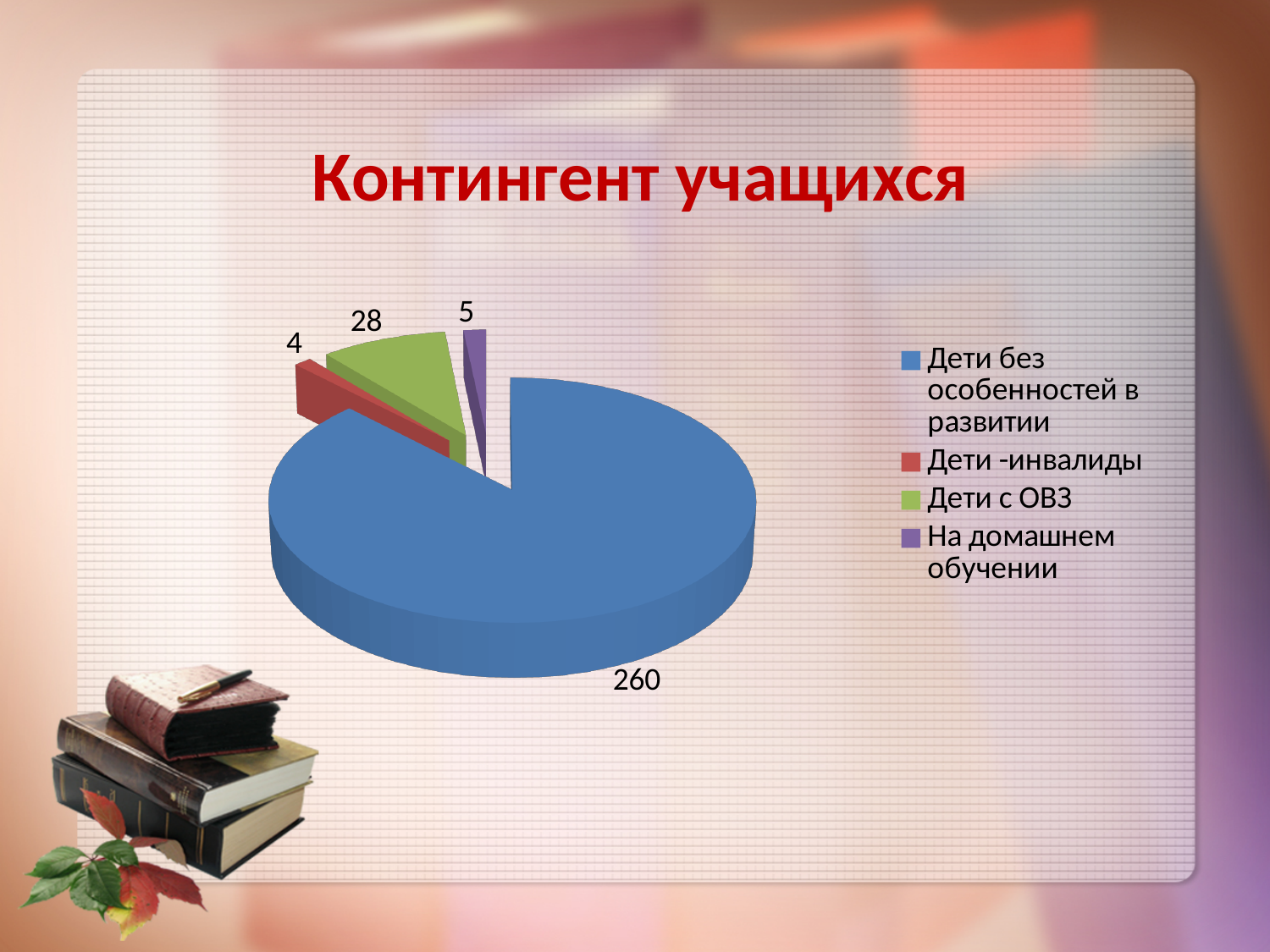
What kind of chart is shown on the slide? Pie chart Which category has the smallest slice? Дети -инвалиды What is the value for "Дети с ОВЗ"? 28 Which is larger: the value for "Дети с ОВЗ" or the value for "На домашнем обучении"? Дети с ОВЗ How many categories does the pie chart have? 4 What is the value for "Дети -инвалиды"? 4 What colour is the slice for "Дети с ОВЗ"? Green What is the title of the chart? Контингент учащихся What is the difference between the values for "Дети без особенностей в развитии" and "Дети с ОВЗ"? 232 What is the value for "На домашнем обучении"? 5 What is the value for "Дети без особенностей в развитии"? 260 Which category has the largest slice? Дети без особенностей в развитии